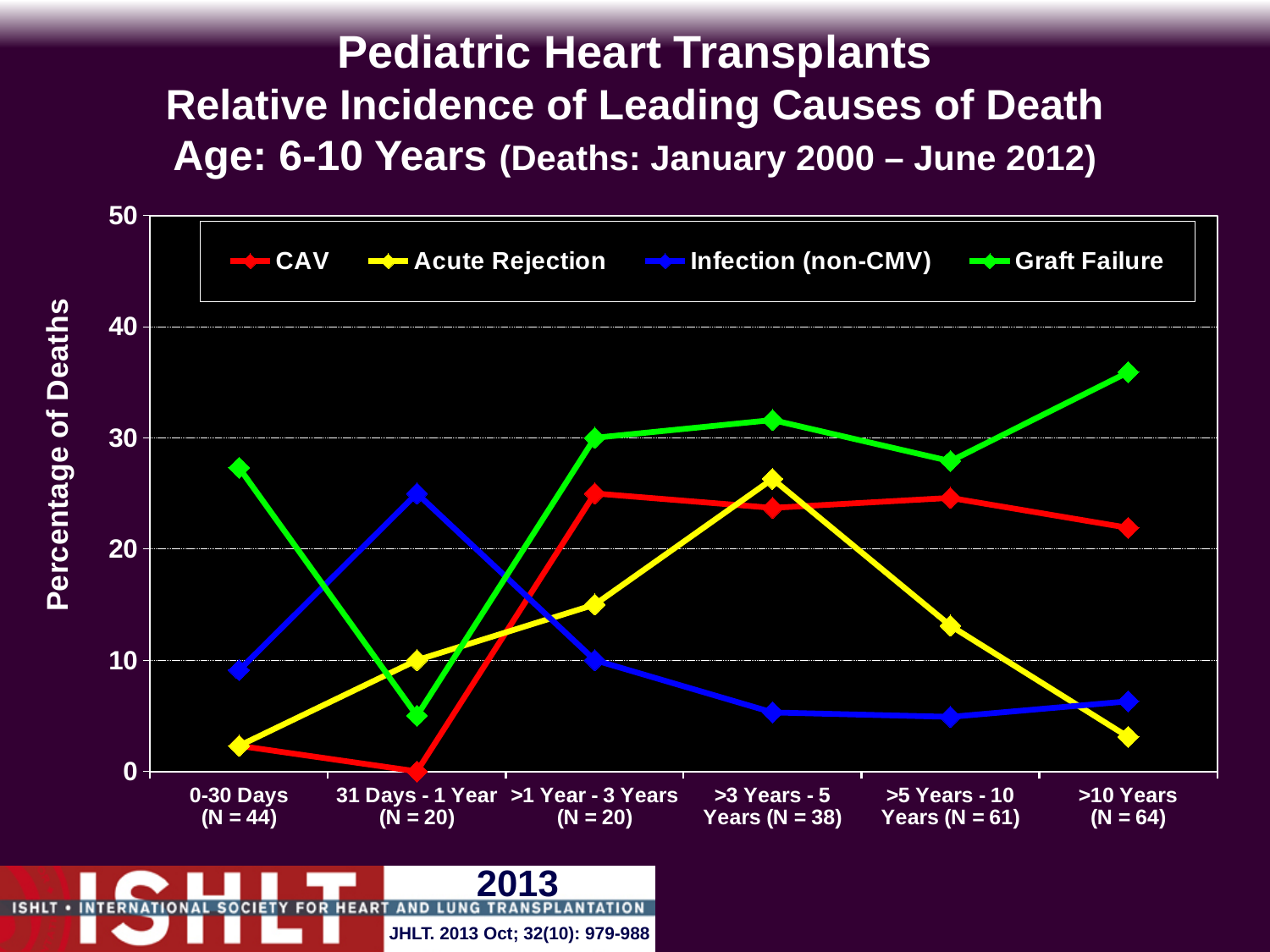
What kind of chart is shown on the slide? line chart In which time period does Acute Rejection reach its highest value? >3 Years - 5 Years How many series does the legend list? 4 Is the value for Graft Failure at >10 Years greater or less than 30? greater Is the value for Infection (non-CMV) at 31 Days - 1 Year greater or less than 20? greater What is the value for CAV at 31 Days - 1 Year? 0 Which cause of death has the highest percentage at >10 Years? Graft Failure Does the Infection (non-CMV) line rise or fall from 31 Days - 1 Year to >5 Years - 10 Years? fall How many time-period categories are shown on the x axis? 6 At 0-30 Days, which is larger: Graft Failure or Infection (non-CMV)? Graft Failure What colour is the Acute Rejection line in the legend? yellow Which cause of death has the lowest percentage at >10 Years? Acute Rejection